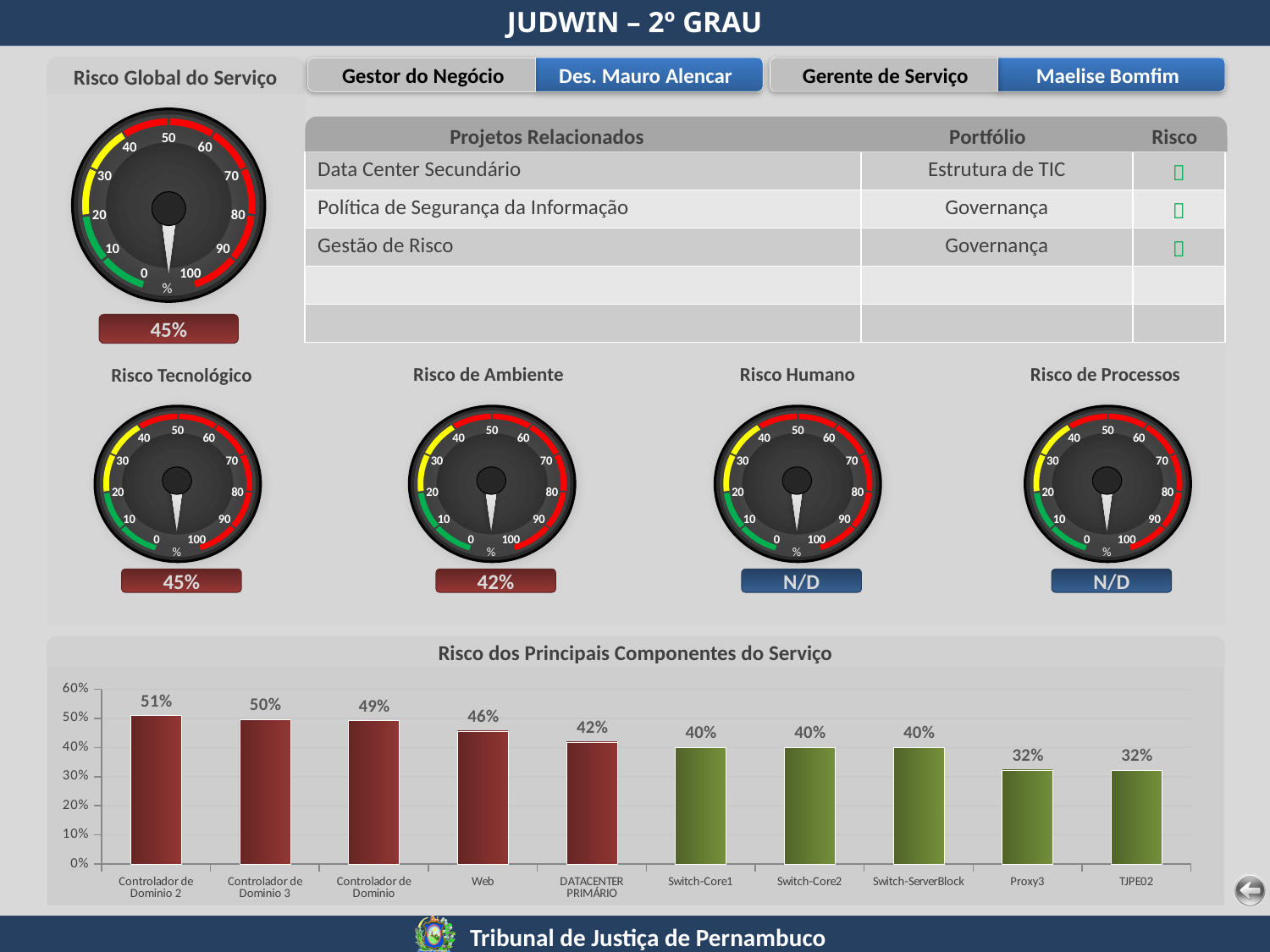
In the bar chart 'Risco dos Principais Componentes do Serviço', what is the difference between Controlador de Dominio 2 and TJPE02? 19% In the bar chart 'Risco dos Principais Componentes do Serviço', what is the value for Web? 46% In the bar chart 'Risco dos Principais Componentes do Serviço', how many components have a value of 40%? 3 What value is shown below the 'Risco Global do Serviço' gauge? 45% In the bar chart 'Risco dos Principais Componentes do Serviço', what is the value for Proxy3? 32% In the bar chart 'Risco dos Principais Componentes do Serviço', which component has the highest value? Controlador de Dominio 2 What kind of chart is 'Risco dos Principais Componentes do Serviço'? bar chart In the bar chart 'Risco dos Principais Componentes do Serviço', do the values rise or fall from left to right? fall In the bar chart 'Risco dos Principais Componentes do Serviço', what is the value for DATACENTER PRIMÁRIO? 42% In the bar chart 'Risco dos Principais Componentes do Serviço', which is larger, Web or Switch-Core1? Web What value is shown below the 'Risco de Ambiente' gauge? 42% In the bar chart 'Risco dos Principais Componentes do Serviço', how many components are shown? 10